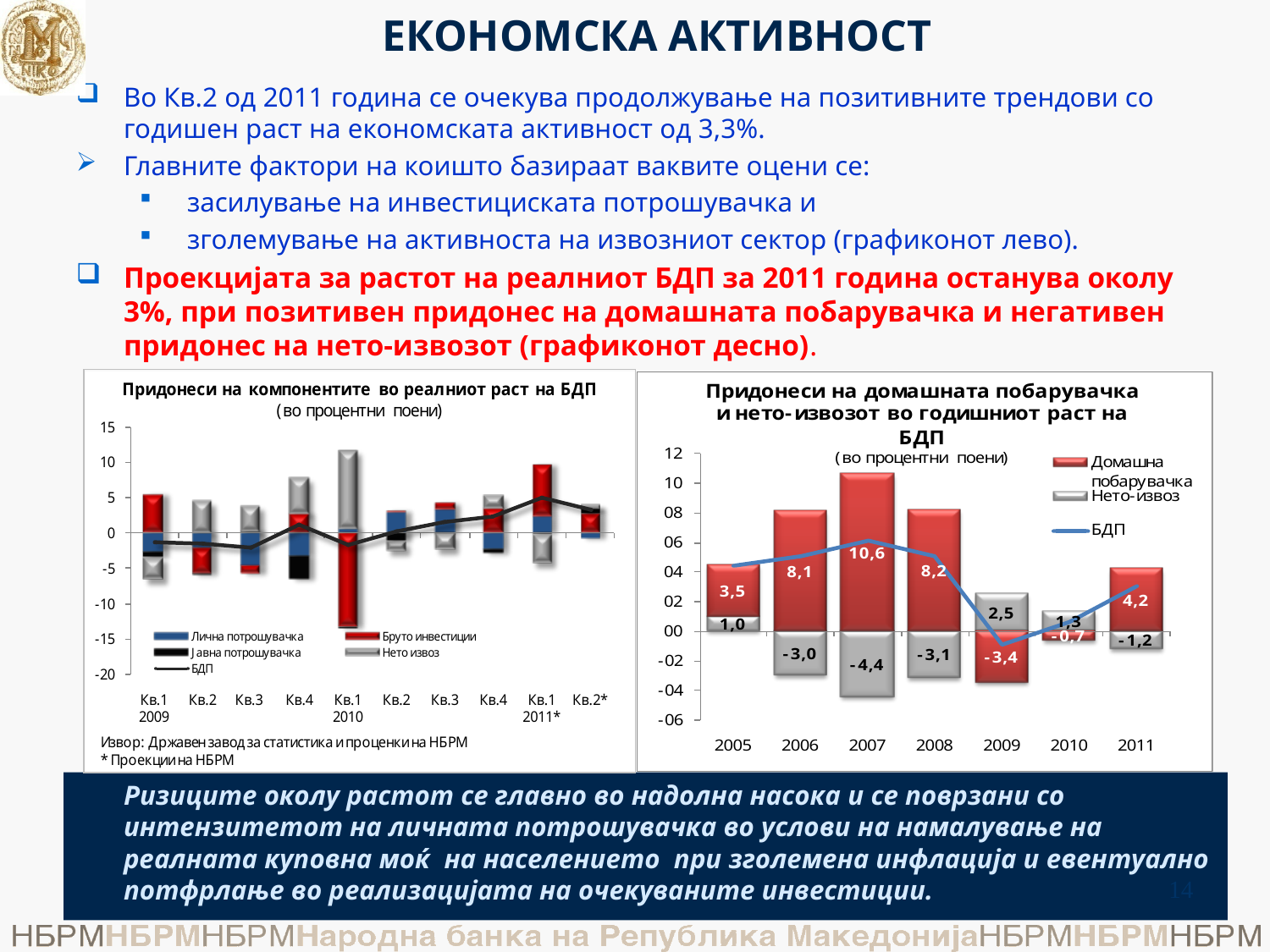
On the right chart (Придонеси на домашната побарувачка и нето-извозот во годишниот раст на БДП), what is the value of Домашна побарувачка for 2007? 10,6 On the right chart, in which year is Нето-извоз lowest? 2007 On the right chart, how many years are shown on the x axis? 7 On the right chart, which year has the larger Нето-извоз value, 2005 or 2010? 2010 What kind of chart is the left chart (Придонеси на компонентите во реалниот раст на БДП)? Stacked bar chart with a line On the right chart, what is the value of Нето-извоз for 2009? 2,5 On the right chart, what is the total of the stacked bar for 2005 (Домашна побарувачка plus Нето-извоз)? 4,5 On the right chart, does Домашна побарувачка rise or fall from 2005 to 2007? rise On the left chart (Придонеси на компонентите во реалниот раст на БДП), how many series does the legend list? 5 On the right chart, in which year is Домашна побарувачка highest? 2007 On the right chart, what is the difference between Домашна побарувачка in 2008 and in 2006? 0,1 On the right chart, in which year is Домашна побарувачка lowest? 2009